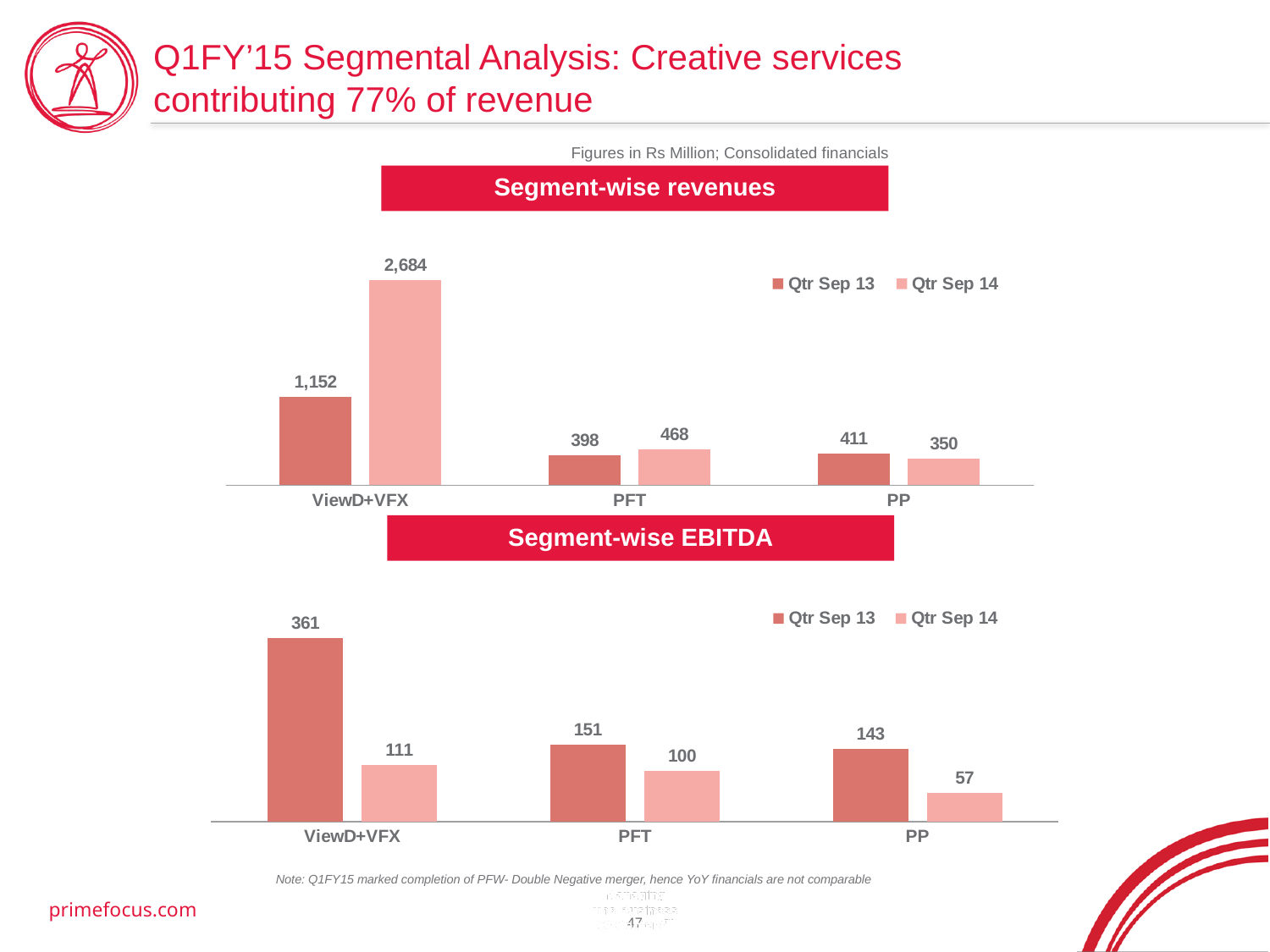
In the Segment-wise revenues chart, which is larger for PFT: Qtr Sep 13 or Qtr Sep 14? Qtr Sep 14 In the Segment-wise EBITDA chart, which is larger for ViewD+VFX: Qtr Sep 13 or Qtr Sep 14? Qtr Sep 13 In the Segment-wise EBITDA chart, what is the difference between the Qtr Sep 13 and Qtr Sep 14 values for PP? 86 What kind of chart is the Segment-wise revenues chart? Bar chart How many segments are shown on the x axis of the Segment-wise EBITDA chart? 3 How many series does the legend of the Segment-wise revenues chart list? 2 In the Segment-wise EBITDA chart, what is the value for PFT in Qtr Sep 14? 100 In the Segment-wise EBITDA chart, which segment has the lowest Qtr Sep 14 value? PP In the Segment-wise revenues chart, what is the difference between the Qtr Sep 14 and Qtr Sep 13 values for ViewD+VFX? 1,532 In the Segment-wise revenues chart, which segment has the highest Qtr Sep 13 value? ViewD+VFX In the Segment-wise revenues chart, what is the value for PP in Qtr Sep 13? 411 In the Segment-wise revenues chart, what is the value for ViewD+VFX in Qtr Sep 14? 2,684